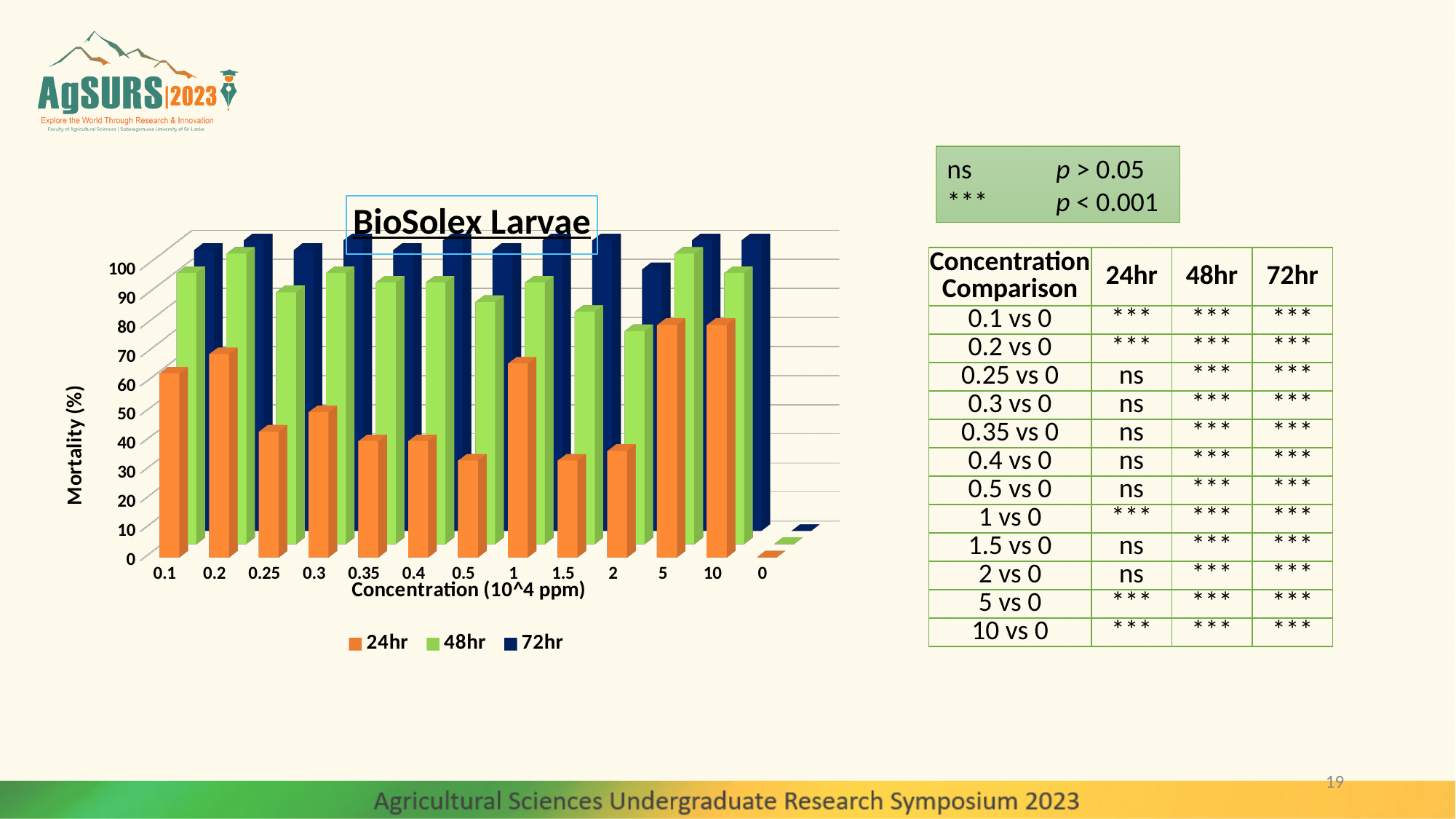
What is the title of the chart? BioSolex Larvae At concentration 0.5, which series has the larger mortality value, 24hr or 48hr? 48hr Which has the larger 24hr mortality value, concentration 0.2 or concentration 0.25? 0.2 How many concentration categories are shown on the x axis of the BioSolex Larvae chart? 13 Is the 24hr mortality value for concentration 0.5 greater or less than 50? less Is the 24hr mortality value for concentration 0.2 greater or less than 50? greater What kind of chart is shown on the slide? bar chart How many series does the legend of the BioSolex Larvae chart list? 3 What is the label of the vertical axis of the chart? Mortality (%) Is the 48hr mortality value for concentration 0.1 greater or less than 50? greater Which has the larger 24hr mortality value, concentration 5 or concentration 0.5? 5 Which concentration category has the lowest 24hr mortality value? 0